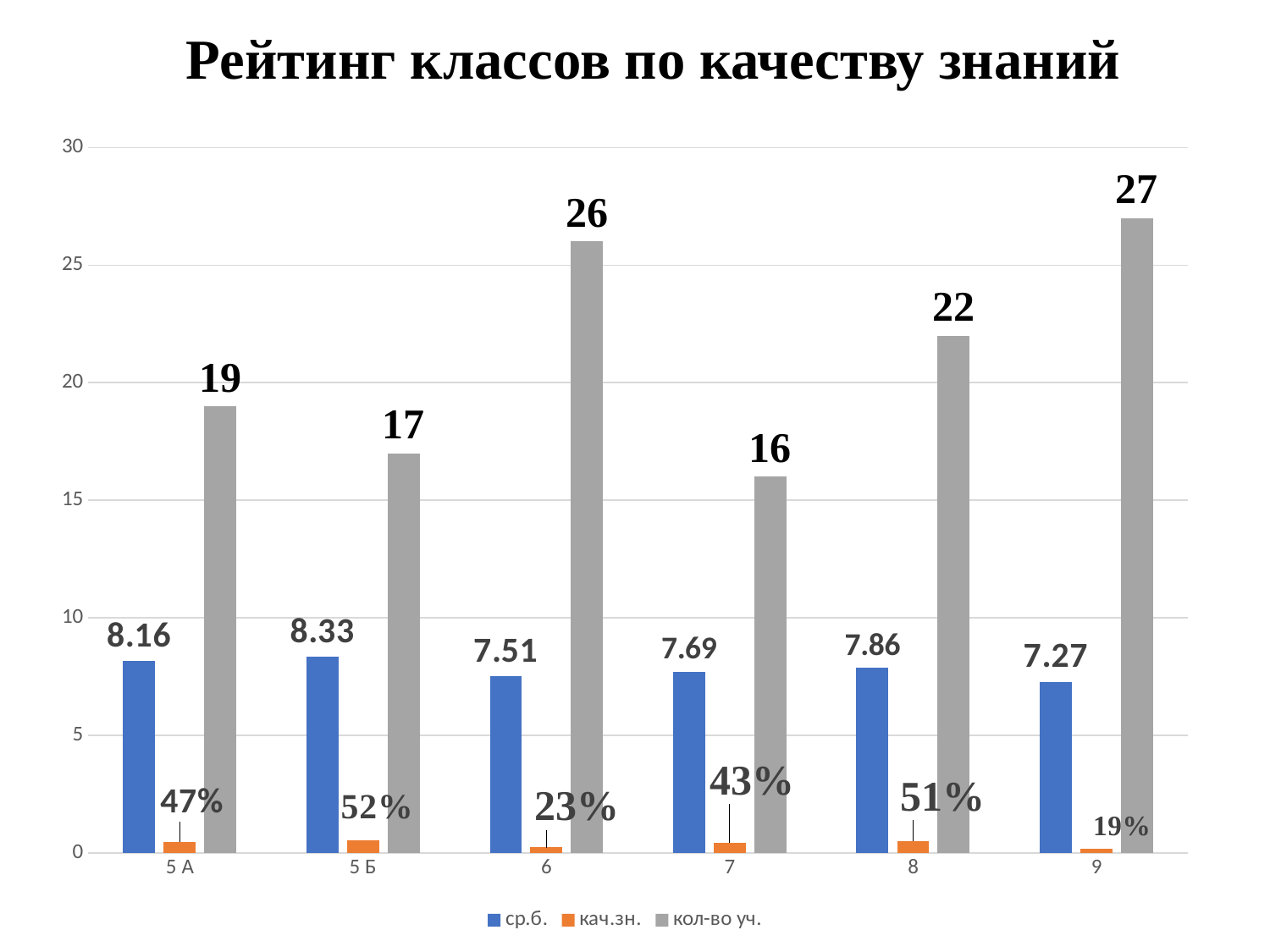
What is the value of 'кол-во уч.' for class 6? 26 What kind of chart is shown on the slide? bar chart Which class has the highest 'кол-во уч.' value? 9 How many series does the legend list? 3 What is the 'кач.зн.' value for class 9? 19% How many classes are shown on the x axis? 6 What is the title of the chart? Рейтинг классов по качеству знаний What is the 'ср.б.' value for class 5 Б? 8.33 Which class has the highest 'кач.зн.' value? 5 Б Which is larger, the 'ср.б.' value for class 5 А or for class 8? 5 А Which class has the lowest 'ср.б.' value? 9 What is the difference in 'кол-во уч.' between class 9 and class 7? 11